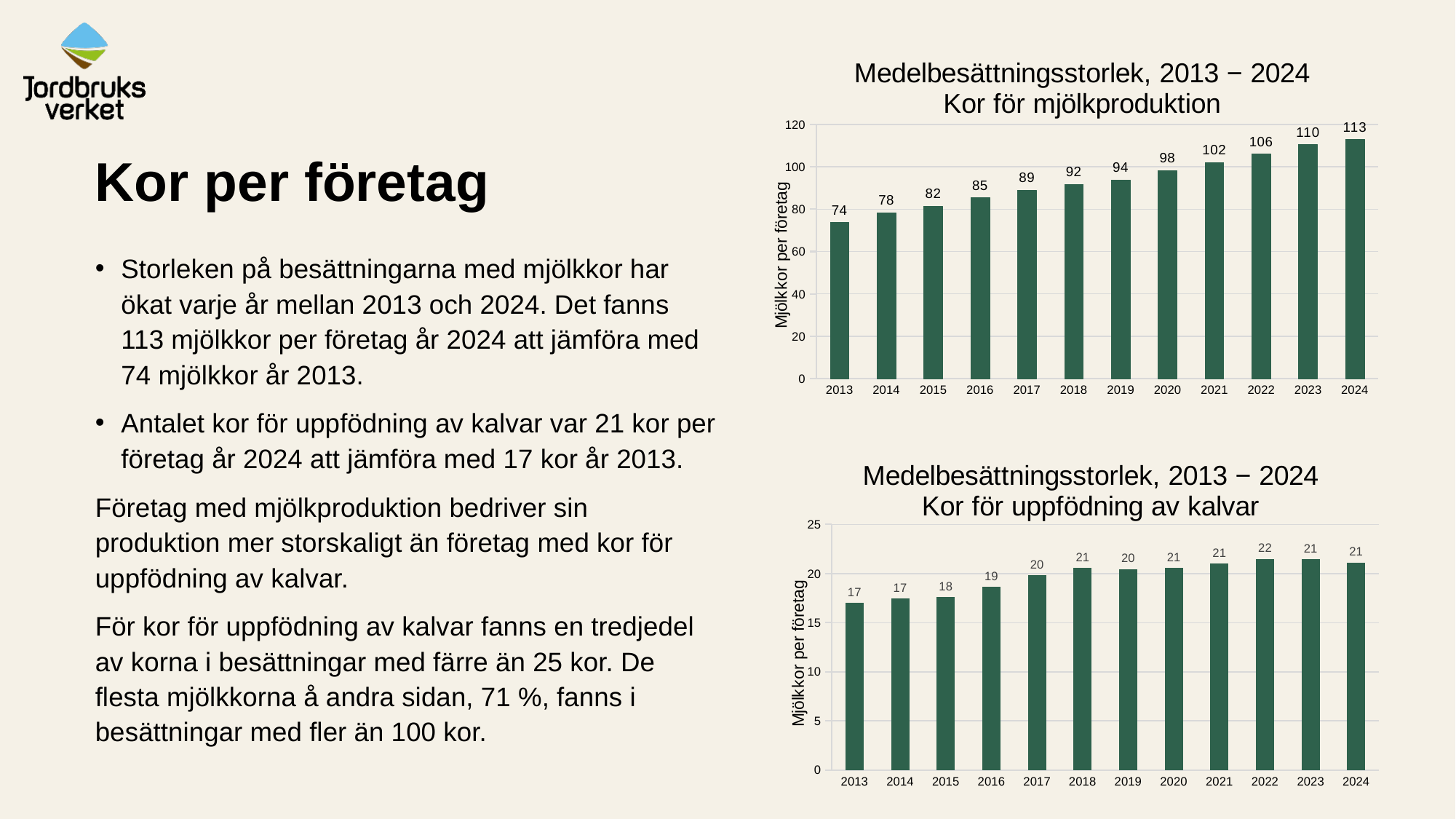
In the top chart (Kor för mjölkproduktion), which year has the lowest value? 2013 In the top chart (Kor för mjölkproduktion), what is the value for 2024? 113 In the bottom chart (Kor för uppfödning av kalvar), what is the value for 2022? 22 In the bottom chart (Kor för uppfödning av kalvar), is the value for 2013 larger or smaller than the value for 2024? smaller In the bottom chart (Kor för uppfödning av kalvar), what is the difference between the values for 2024 and 2013? 4 In the top chart (Kor för mjölkproduktion), which year has the highest value? 2024 In the bottom chart (Kor för uppfödning av kalvar), what is the value for 2016? 19 What type of chart is the top chart (Kor för mjölkproduktion)? bar chart In the top chart (Kor för mjölkproduktion), do the values rise or fall from 2013 to 2024? rise In the top chart (Kor för mjölkproduktion), how many years are shown on the x axis? 12 In the top chart (Kor för mjölkproduktion), what is the difference between the values for 2024 and 2013? 39 In the top chart (Kor för mjölkproduktion), what is the value for 2013? 74